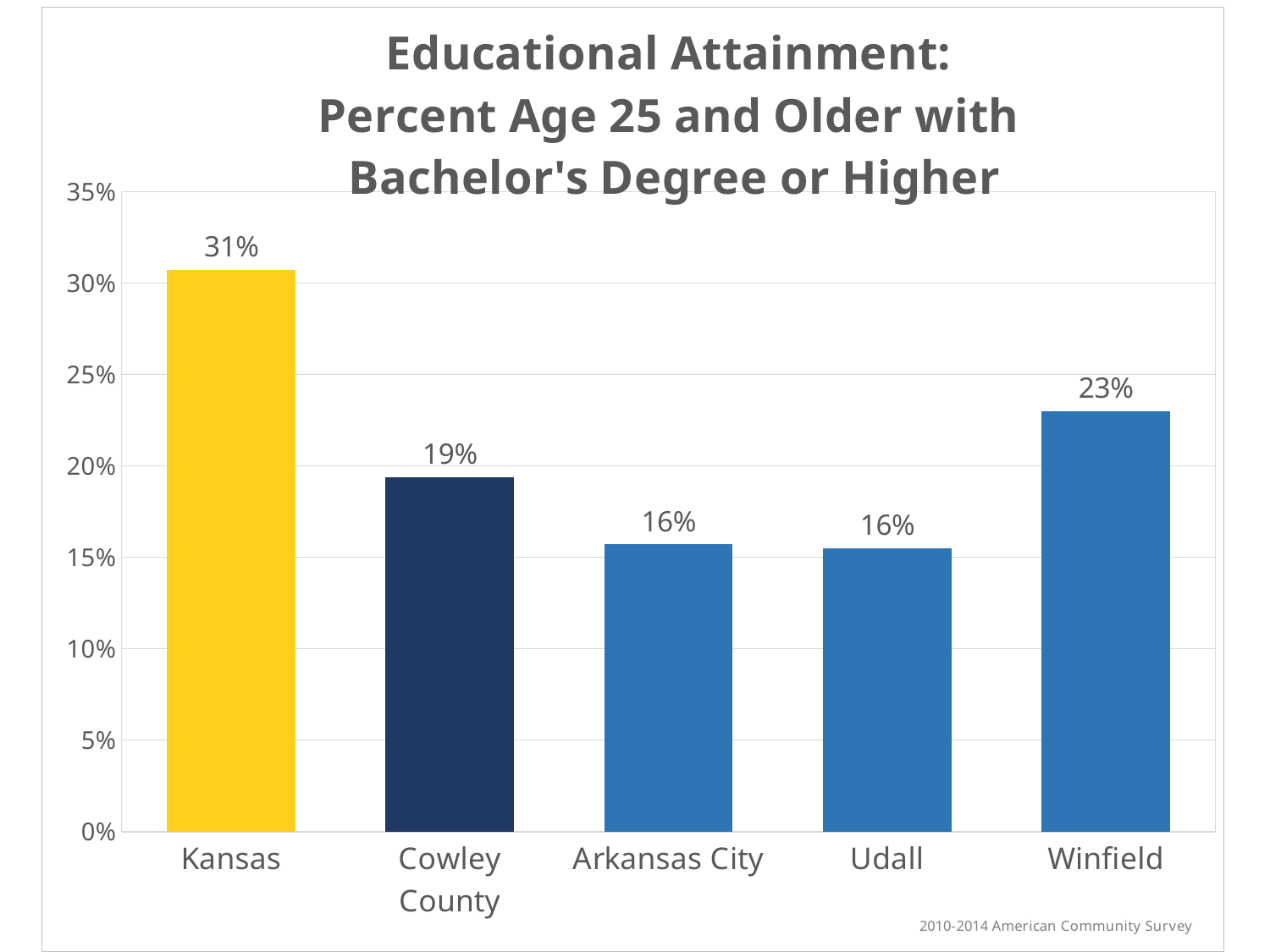
What is the value for Arkansas City? 16% What is the difference between the values for Kansas and Winfield? 8% What is the difference between the values for Winfield and Cowley County? 4% What is the value for Kansas? 31% What kind of chart is shown on the slide? bar chart Which is larger, the value for Winfield or the value for Cowley County? Winfield Is the value for Udall greater or less than 20%? less What is the value for Winfield? 23% How many categories are shown on the chart? 5 What is the value for Cowley County? 19% Which category has the highest value? Kansas What data source is cited at the bottom of the chart? 2010-2014 American Community Survey